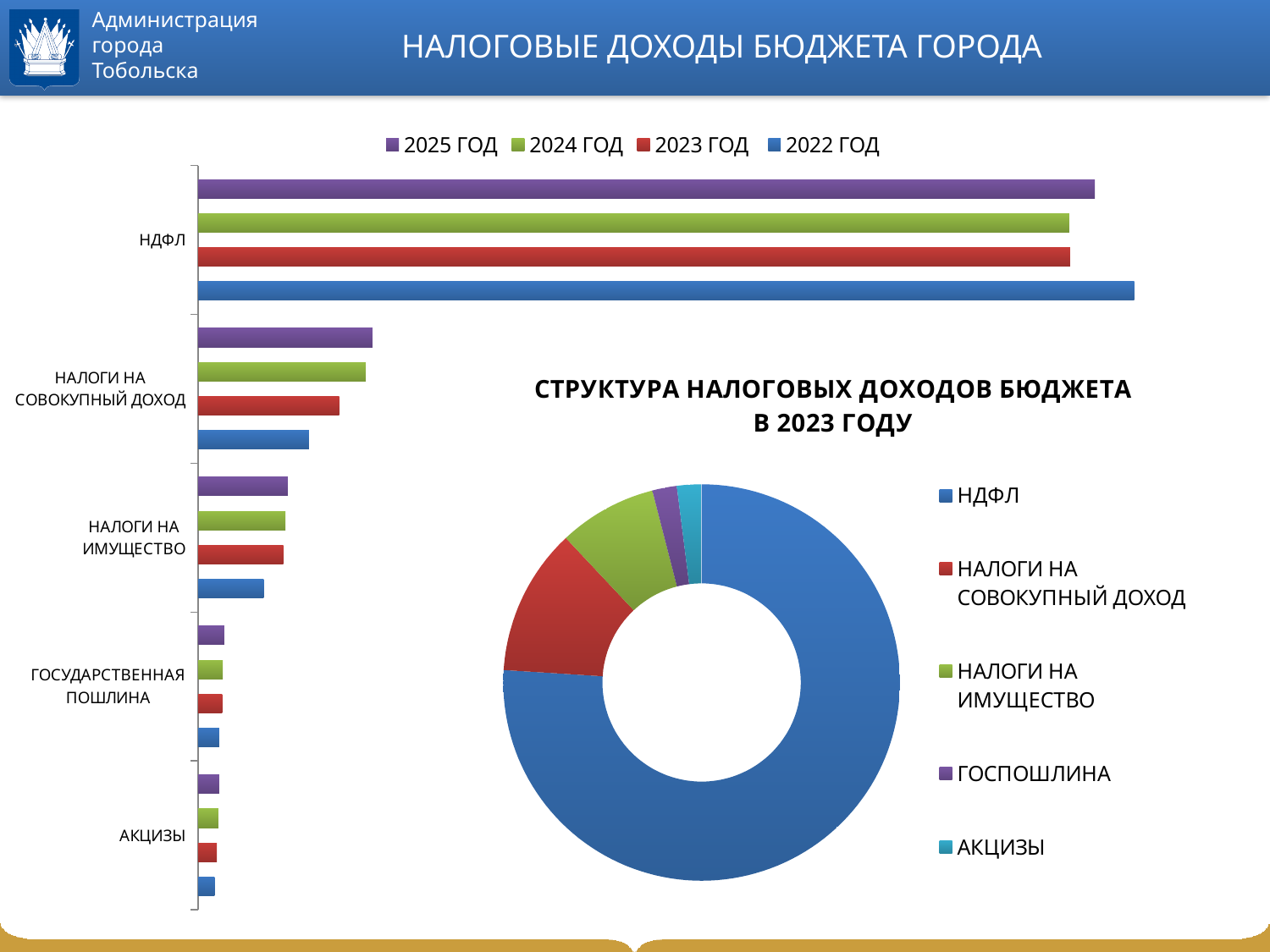
What kind of chart is the chart on the left side of the slide? bar chart In the doughnut chart, which slice is larger: НАЛОГИ НА СОВОКУПНЫЙ ДОХОД or НАЛОГИ НА ИМУЩЕСТВО? НАЛОГИ НА СОВОКУПНЫЙ ДОХОД In the bar chart on the left, for НДФЛ, which is larger: the 2022 ГОД bar or the 2025 ГОД bar? 2022 ГОД In the bar chart on the left, what colour represents the 2023 ГОД series? red In the doughnut chart, how many slices are there? 5 In the bar chart on the left, for НАЛОГИ НА ИМУЩЕСТВО, which is larger: the 2022 ГОД bar or the 2025 ГОД bar? 2025 ГОД In the bar chart on the left, how many categories are shown on the vertical axis? 5 In the bar chart on the left, how many series does the legend list? 4 In the bar chart on the left, which category has the longest bars? НДФЛ In the doughnut chart, which category has the largest slice? НДФЛ What kind of chart is the chart titled "СТРУКТУРА НАЛОГОВЫХ ДОХОДОВ БЮДЖЕТА В 2023 ГОДУ"? doughnut chart